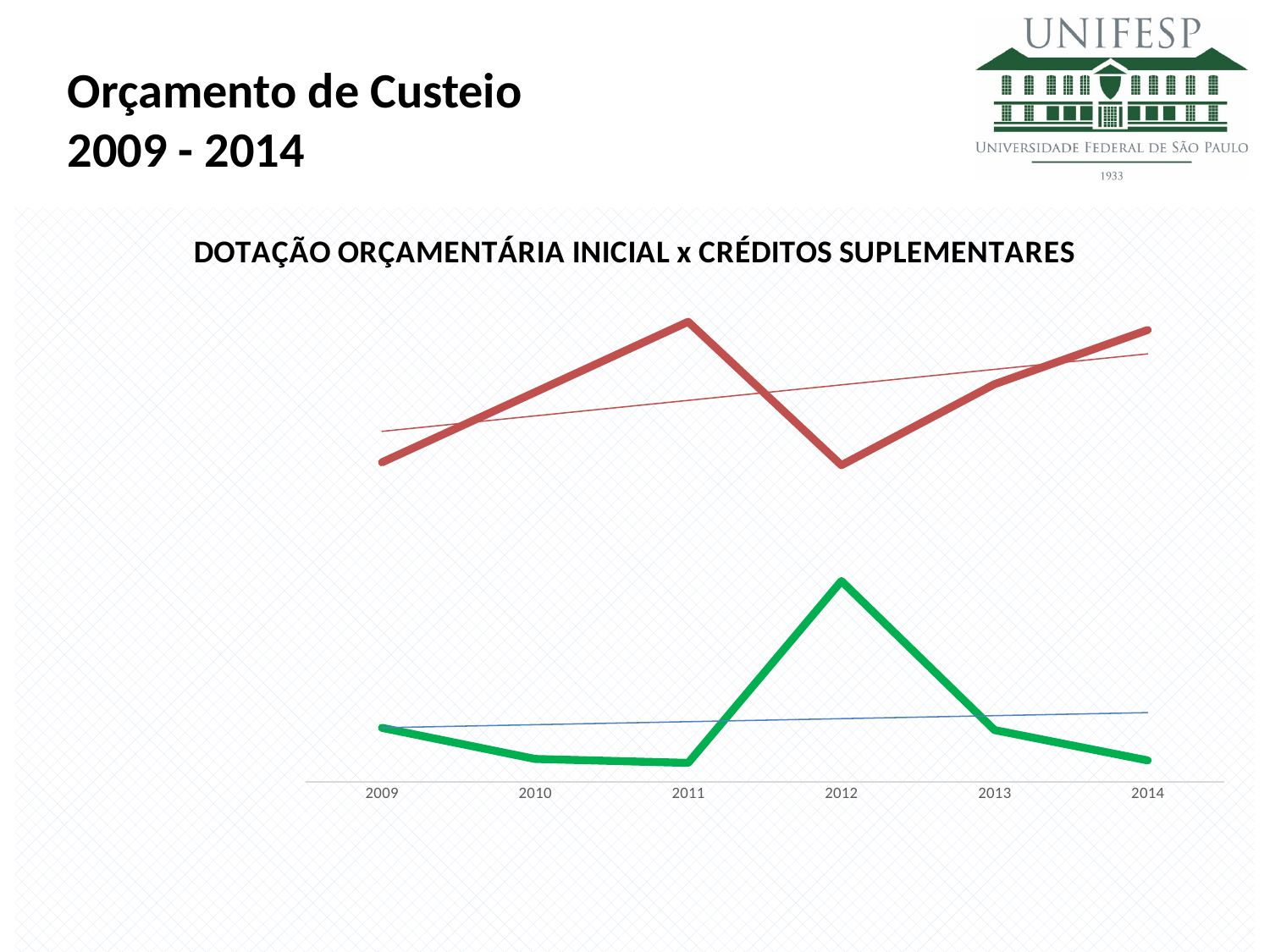
Which colours are the two thick data lines on the chart? red and green What is the title of the chart? DOTAÇÃO ORÇAMENTÁRIA INICIAL x CRÉDITOS SUPLEMENTARES In which year does the red line reach its highest point? 2011 Does the green line rise or fall from 2012 to 2014? fall How many data lines (excluding the thin trend lines) are plotted on the chart? 2 How many years are shown on the x axis of the chart? 6 In which year does the green line reach its highest point? 2012 In 2012, which line has the higher value, the red line or the green line? red line Does the red line rise or fall from 2009 to 2011? rise Does the red line rise or fall from 2011 to 2012? fall What kind of chart is shown on the slide? line chart